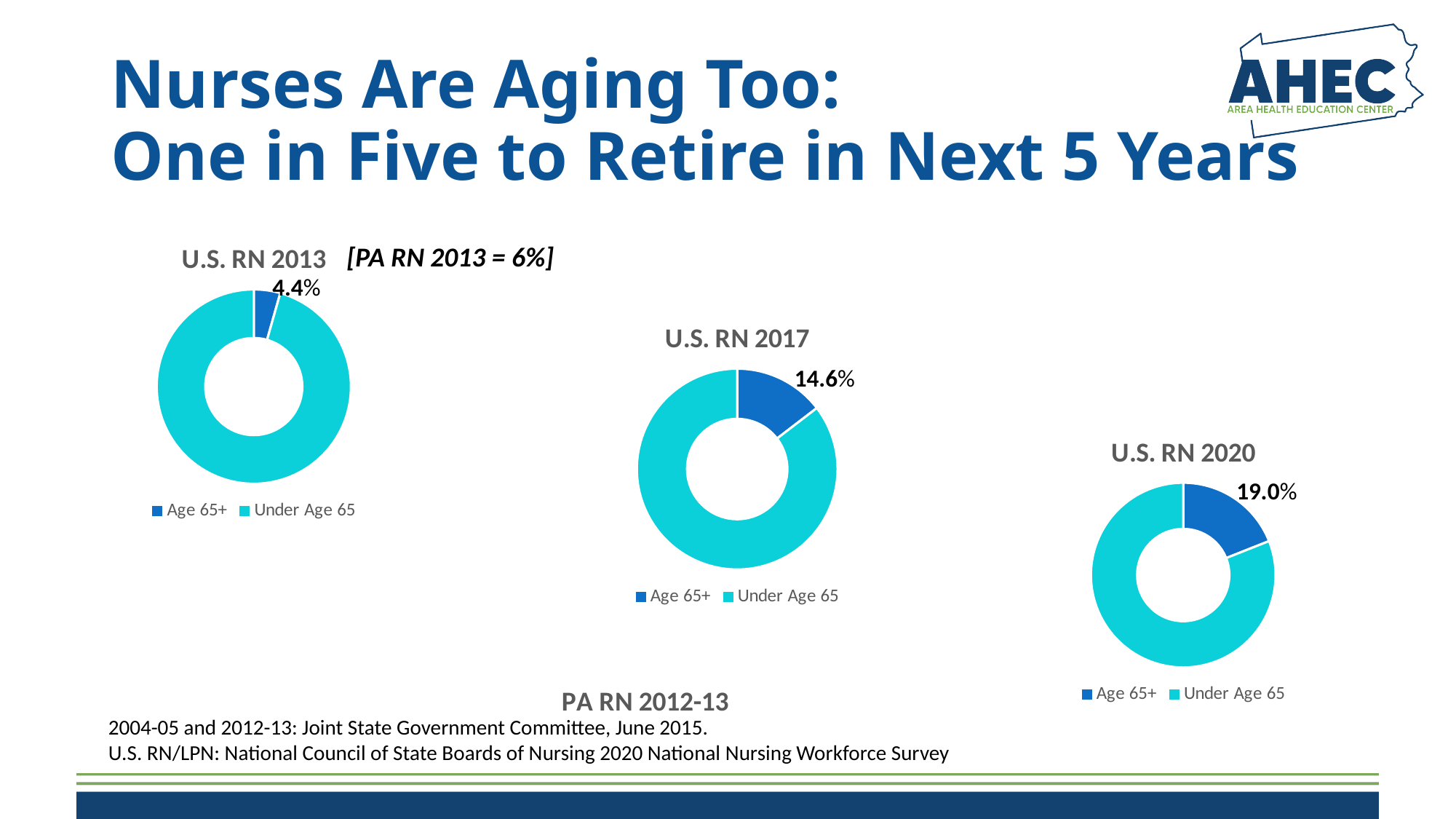
Is the Age 65+ share larger in the U.S. RN 2017 chart or the U.S. RN 2020 chart? U.S. RN 2020 In the U.S. RN 2013 chart, which category is shown in dark blue? Age 65+ In the U.S. RN 2017 chart, what percentage of nurses are Age 65+? 14.6% What kind of chart is the U.S. RN 2020 chart? Donut (pie) chart What is the difference in the Age 65+ percentage between the U.S. RN 2020 chart and the U.S. RN 2013 chart? 14.6 percentage points Does the Age 65+ share rise or fall from the 2013 chart to the 2020 chart? Rise Across the three charts, which year has the highest Age 65+ percentage? U.S. RN 2020 In the U.S. RN 2013 chart, what percentage of nurses are Age 65+? 4.4% In the U.S. RN 2020 chart, what percentage of nurses are Age 65+? 19.0% Across the three charts, which year has the lowest Age 65+ percentage? U.S. RN 2013 What is the difference in the Age 65+ percentage between the U.S. RN 2017 chart and the U.S. RN 2013 chart? 10.2 percentage points How many categories does the legend of the U.S. RN 2017 chart list? 2